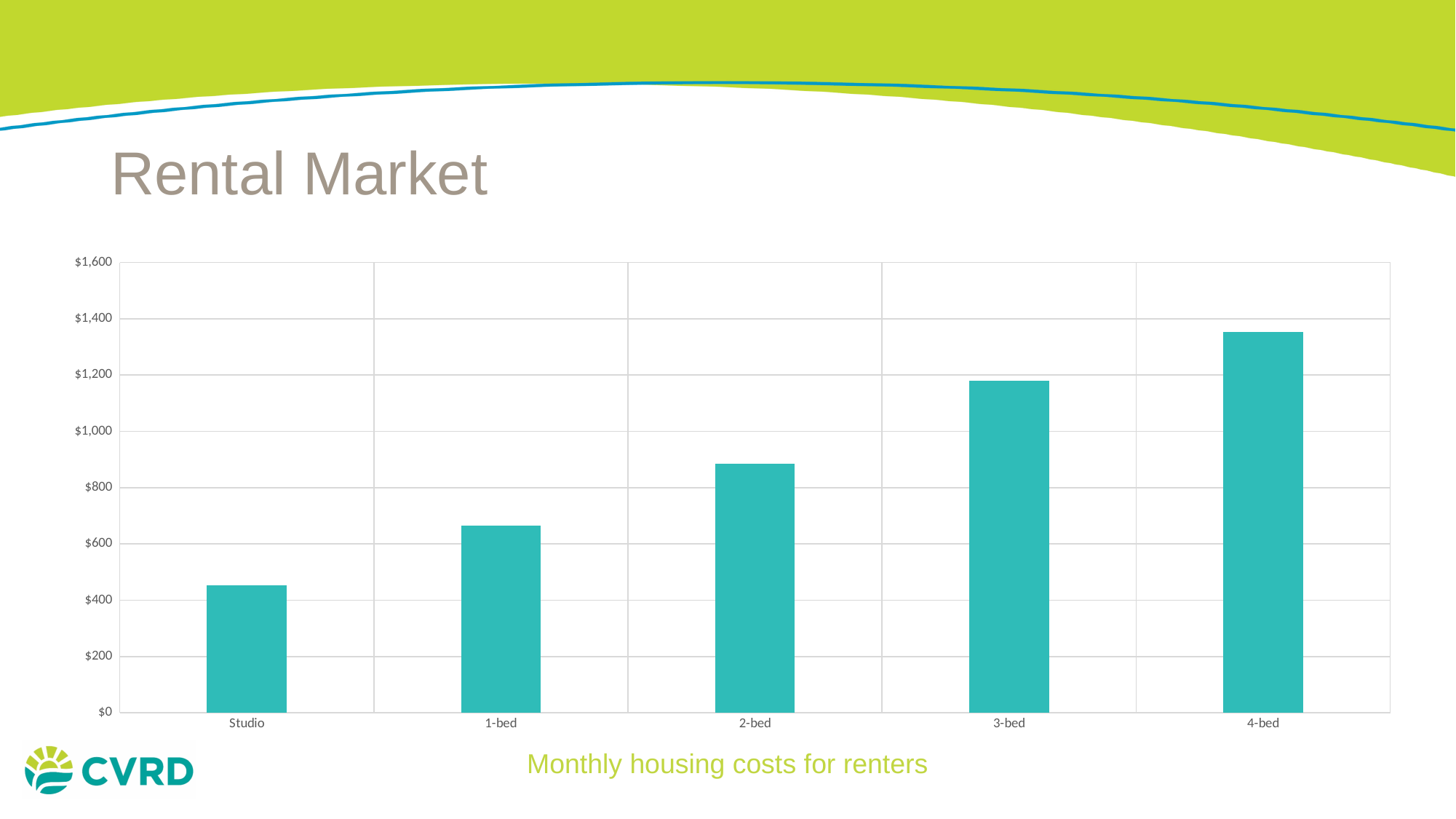
Do the values rise or fall moving from Studio to 4-bed along the x axis? rise What type of chart is shown on the slide? bar chart Is the value for 4-bed greater or less than $1,400? less Is the value for 3-bed greater or less than $1,000? greater Is the value for 2-bed greater or less than $800? greater How many categories are shown on the x axis of the chart? 5 Which is larger, the value for 2-bed or the value for 1-bed? 2-bed Which category has the highest monthly housing cost? 4-bed What is the caption shown below the chart? Monthly housing costs for renters Which category has the lowest monthly housing cost? Studio